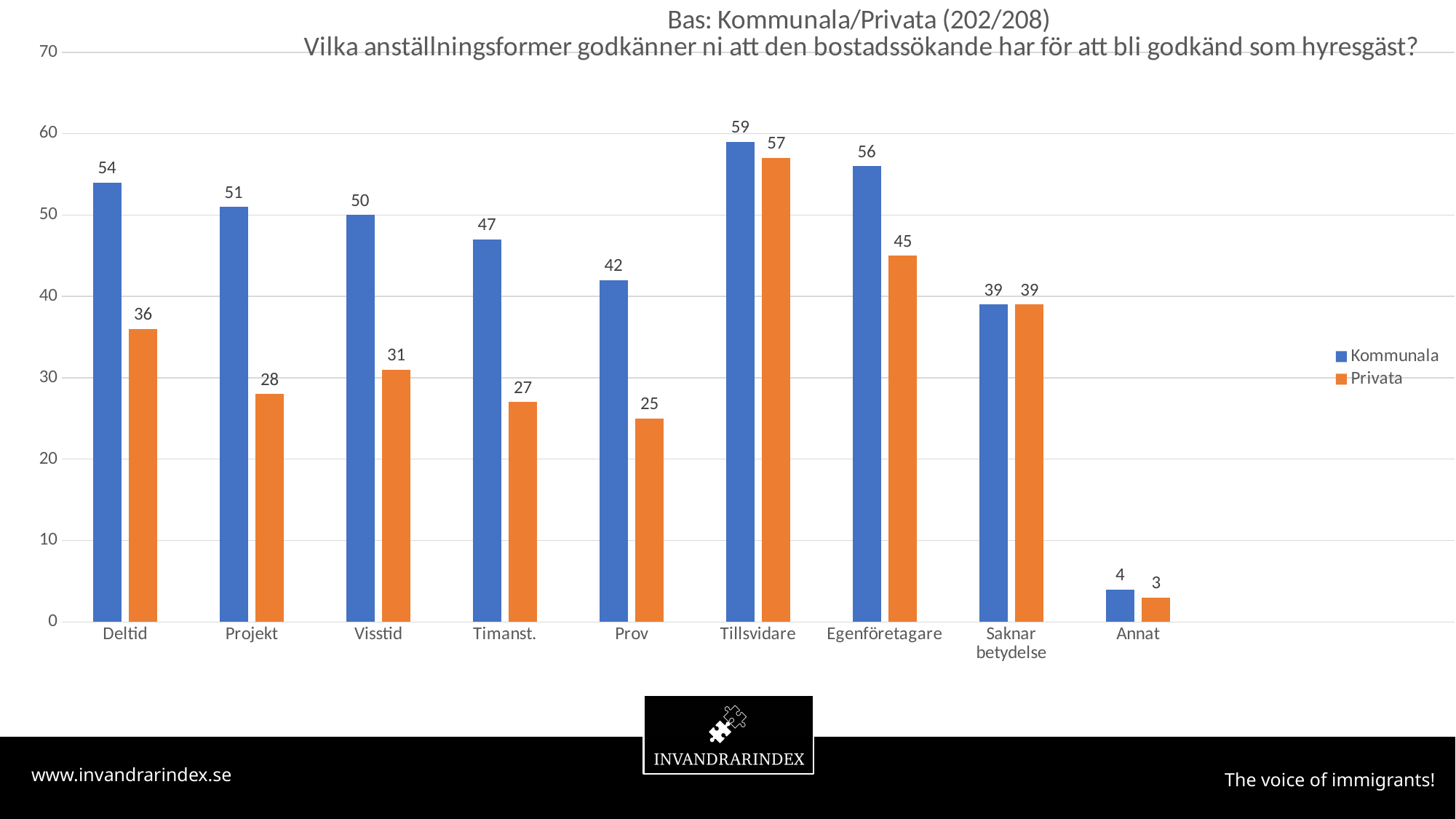
Which is larger for Egenföretagare, the Kommunala value or the Privata value? Kommunala Is the Kommunala value for Timanst. greater or less than 40? greater Which category has the highest Kommunala value? Tillsvidare What is the difference between the Kommunala and Privata values for Projekt? 23 Which colour represents the Privata series? orange What is the Privata value for Prov? 25 What is the Kommunala value for Deltid? 54 What is the Privata value for Tillsvidare? 57 How many categories are shown on the x axis? 9 How many series does the legend list? 2 What kind of chart is shown on the slide? bar chart Which category has the lowest Privata value? Annat